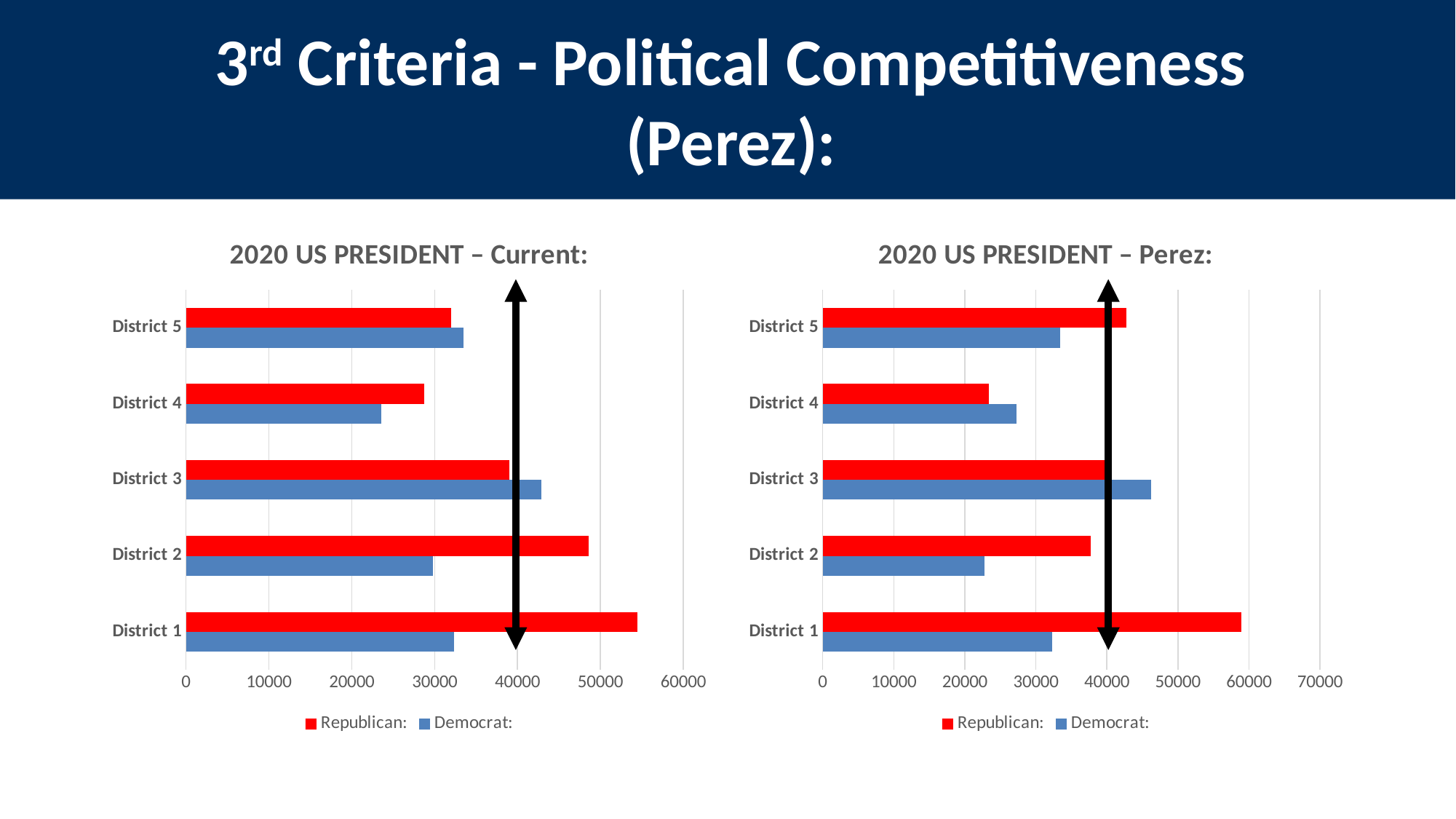
In the chart titled "2020 US PRESIDENT – Perez:", which district has the lowest Republican value? District 4 In the chart titled "2020 US PRESIDENT – Current:", is the Republican value for District 1 greater or less than 50000? greater In the chart titled "2020 US PRESIDENT – Current:", how many districts are plotted? 5 In the chart titled "2020 US PRESIDENT – Current:", what kind of chart is shown? bar chart In the chart titled "2020 US PRESIDENT – Current:", which district has the highest Republican value? District 1 In the chart titled "2020 US PRESIDENT – Current:", how many series does the legend list? 2 In the chart titled "2020 US PRESIDENT – Perez:", is the Democrat value for District 3 greater or less than 40000? greater In the chart titled "2020 US PRESIDENT – Current:", which district has the lowest Democrat value? District 4 In the chart titled "2020 US PRESIDENT – Perez:", which district has the highest Democrat value? District 3 In the chart titled "2020 US PRESIDENT – Perez:", which district has the highest Republican value? District 1 In the chart titled "2020 US PRESIDENT – Current:", which is larger for District 2, the Republican value or the Democrat value? Republican In the chart titled "2020 US PRESIDENT – Perez:", which is larger for District 4, the Republican value or the Democrat value? Democrat